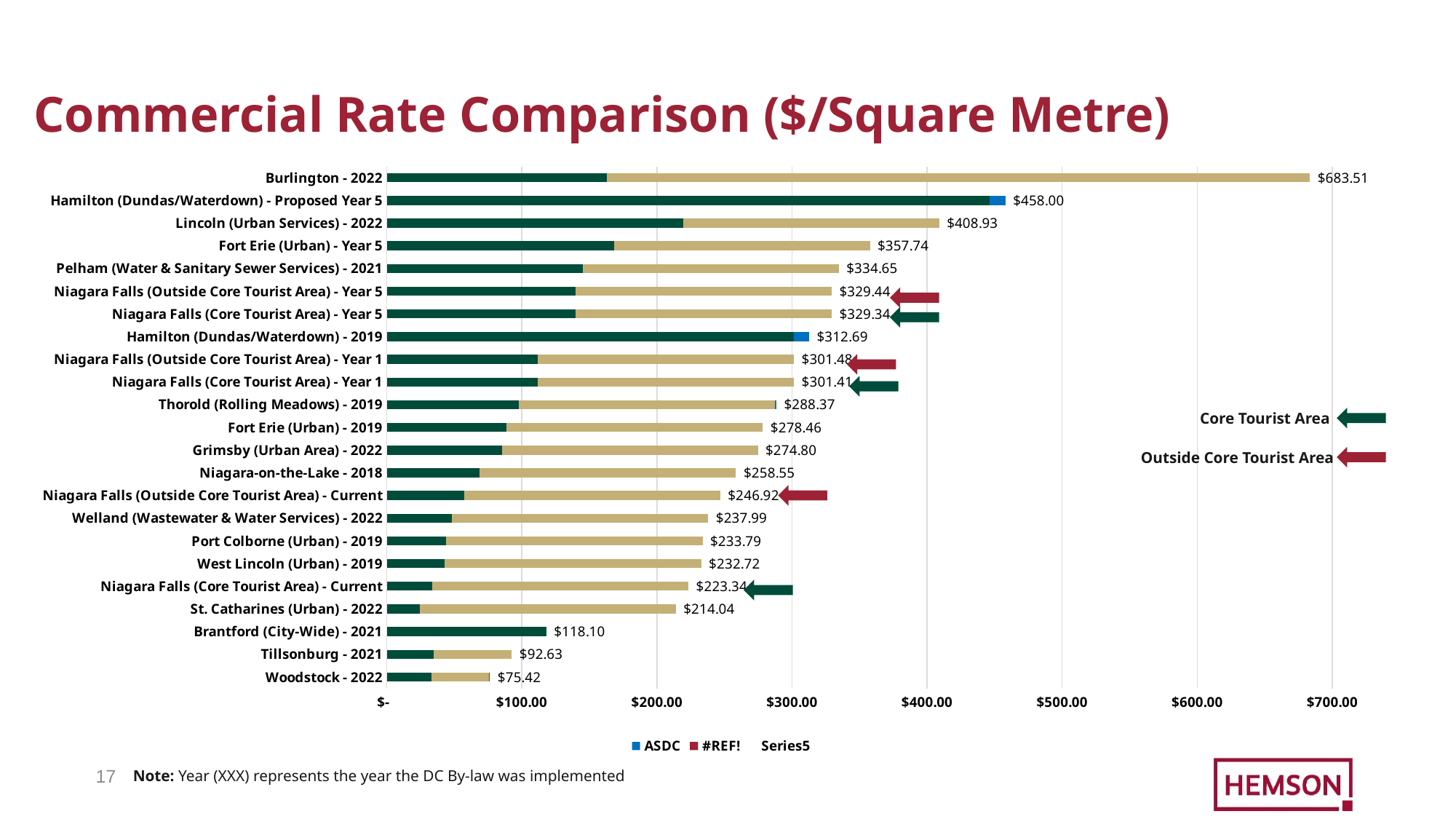
How many series does the legend list? 3 Which category has the highest labelled value? Burlington - 2022 What is the labelled value for Niagara Falls (Core Tourist Area) - Current? $223.34 What is the labelled value for Hamilton (Dundas/Waterdown) - Proposed Year 5? $458.00 What is the difference between the labelled values for Hamilton (Dundas/Waterdown) - Proposed Year 5 and Hamilton (Dundas/Waterdown) - 2019? $145.31 Which has the larger labelled value, Fort Erie (Urban) - 2019 or Grimsby (Urban Area) - 2022? Fort Erie (Urban) - 2019 How many categories (bars) are shown in the chart? 23 Is the value for Brantford (City-Wide) - 2021 greater or less than $100.00? greater What is the difference between the labelled values for Lincoln (Urban Services) - 2022 and Fort Erie (Urban) - Year 5? $51.19 What type of chart is shown on the slide? Stacked bar chart Which category has the lowest labelled value? Woodstock - 2022 What is the labelled value for Burlington - 2022? $683.51